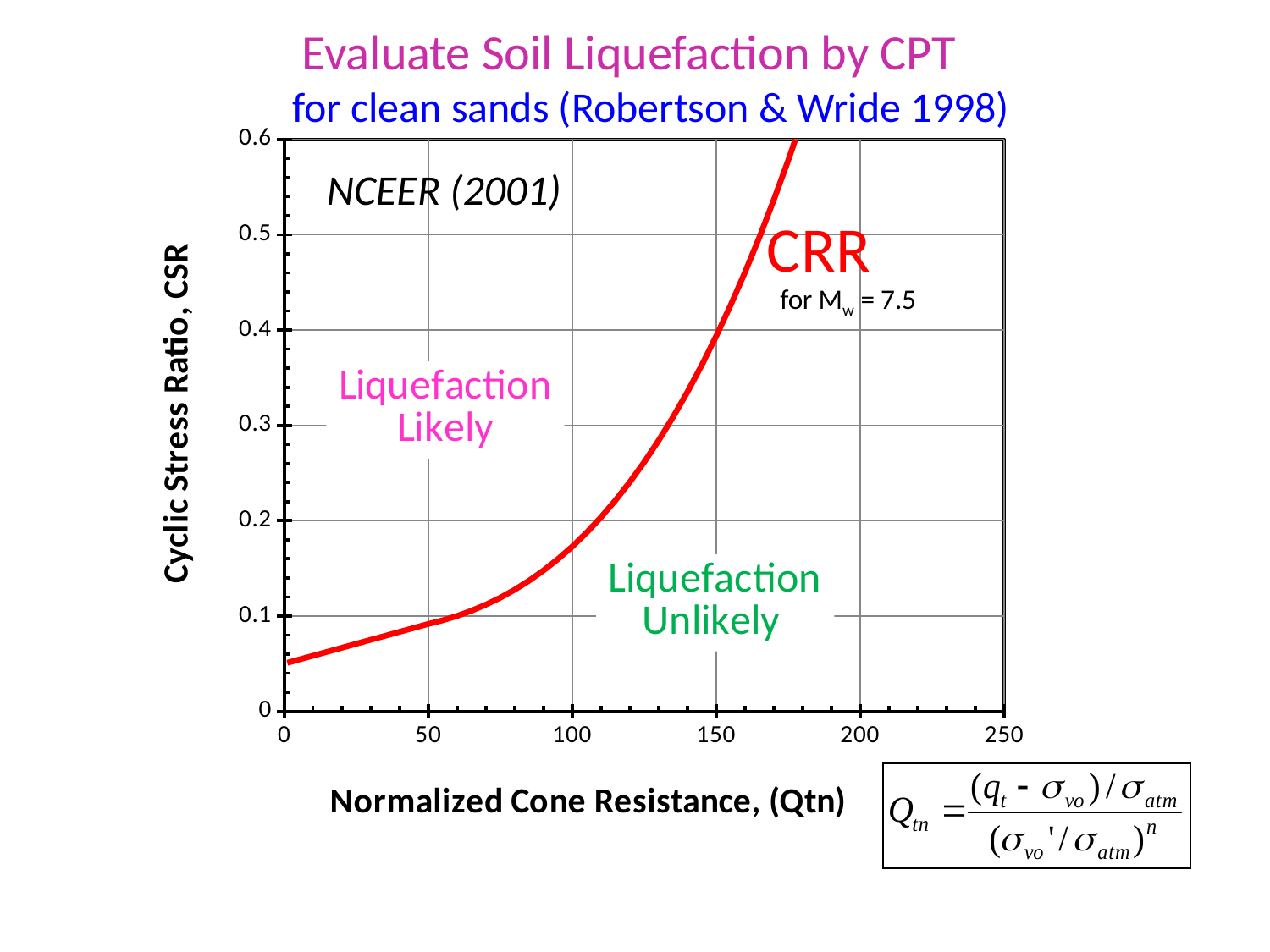
What is the maximum value shown on the x axis? 250 Is the CRR value at a Normalized Cone Resistance of 100 greater or less than 0.1? greater Is the CRR value at a Normalized Cone Resistance of 50 greater or less than 0.2? less What is the title of the x axis? Normalized Cone Resistance, (Qtn) Is the CRR value at a Normalized Cone Resistance of 125 greater or less than 0.3? less How many curves are plotted on the chart? 1 What kind of chart is shown on the slide? line chart Does the CRR curve rise or fall as Normalized Cone Resistance increases? rise What is the title of the y axis? Cyclic Stress Ratio, CSR